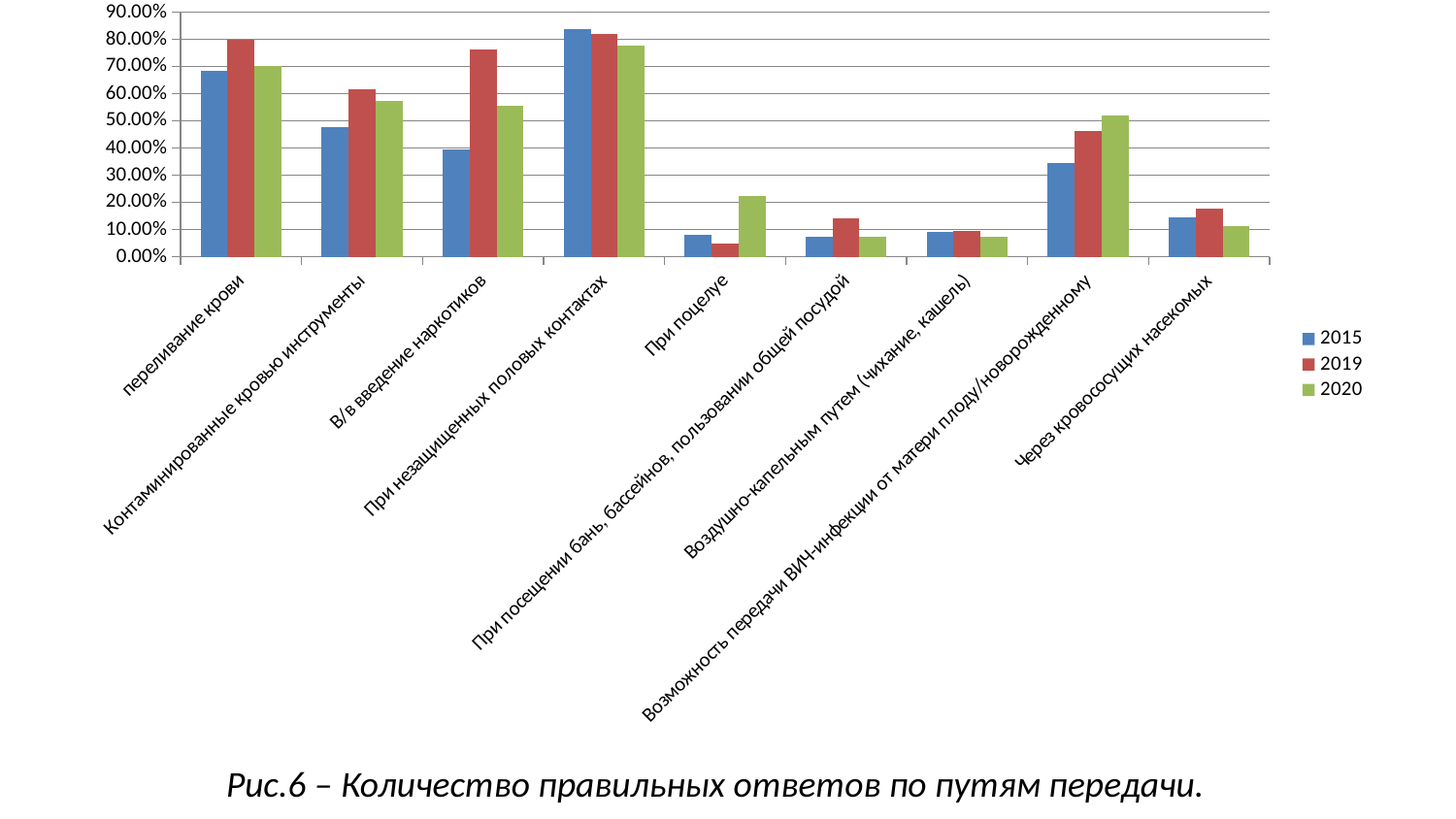
Is the 2019 value for 'В/в введение наркотиков' greater or less than 70.00%? greater Which category has the highest value for the 2015 series? При незащищенных половых контактах Is the 2015 value for 'переливание крови' greater or less than 60.00%? greater For 'Возможность передачи ВИЧ-инфекции от матери плоду/новорожденному', which series has the larger value, 2015 or 2020? 2020 Which category has the lowest value for the 2019 series? При поцелуе What kind of chart is shown on the slide? Bar chart For 'В/в введение наркотиков', which series has the larger value, 2015 or 2019? 2019 How many categories are shown on the x axis? 9 How many series does the legend list? 3 Which category has the highest value for the 2020 series? При незащищенных половых контактах What are the entries listed in the legend? 2015, 2019, 2020 Is the 2020 value for 'При поцелуе' greater or less than 10.00%? greater